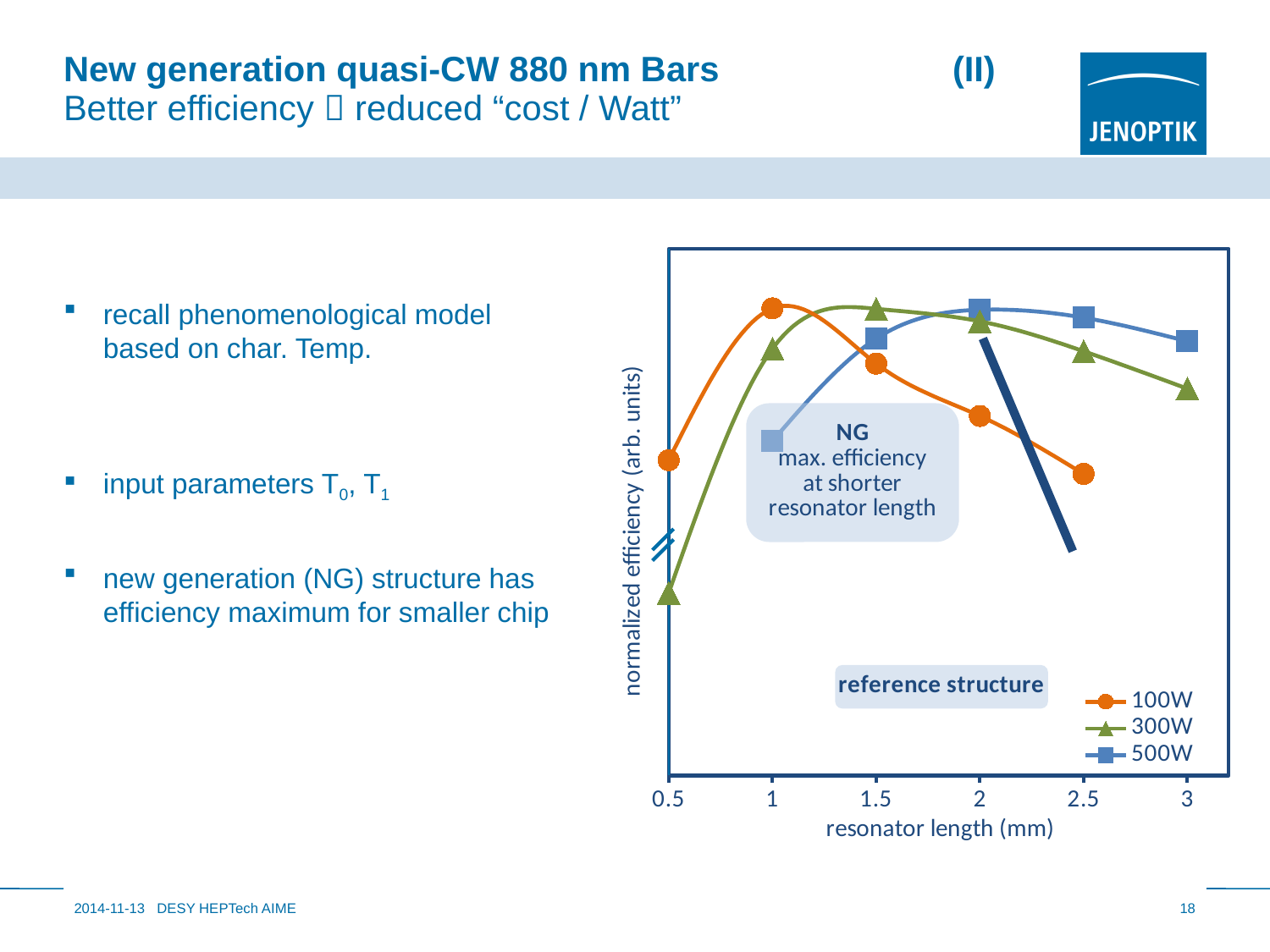
What are the series names listed in the chart legend? 100W, 300W, 500W At which resonator length does the 300W series reach its highest normalized efficiency? 1.5 At which resonator length is the 300W series at its lowest value? 0.5 How many data points are plotted for the 100W series? 5 At which resonator length does the 100W series reach its highest normalized efficiency? 1 How many data points are plotted for the 300W series? 6 What is the label of the x axis of the chart? resonator length (mm) Does the 100W series rise or fall as the resonator length increases from 1 mm to 2.5 mm? fall At a resonator length of 1 mm, which series has the higher normalized efficiency, 100W or 300W? 100W How many series does the chart legend list? 3 What kind of chart is shown on the slide? line chart At which resonator length does the 500W series reach its highest normalized efficiency? 2